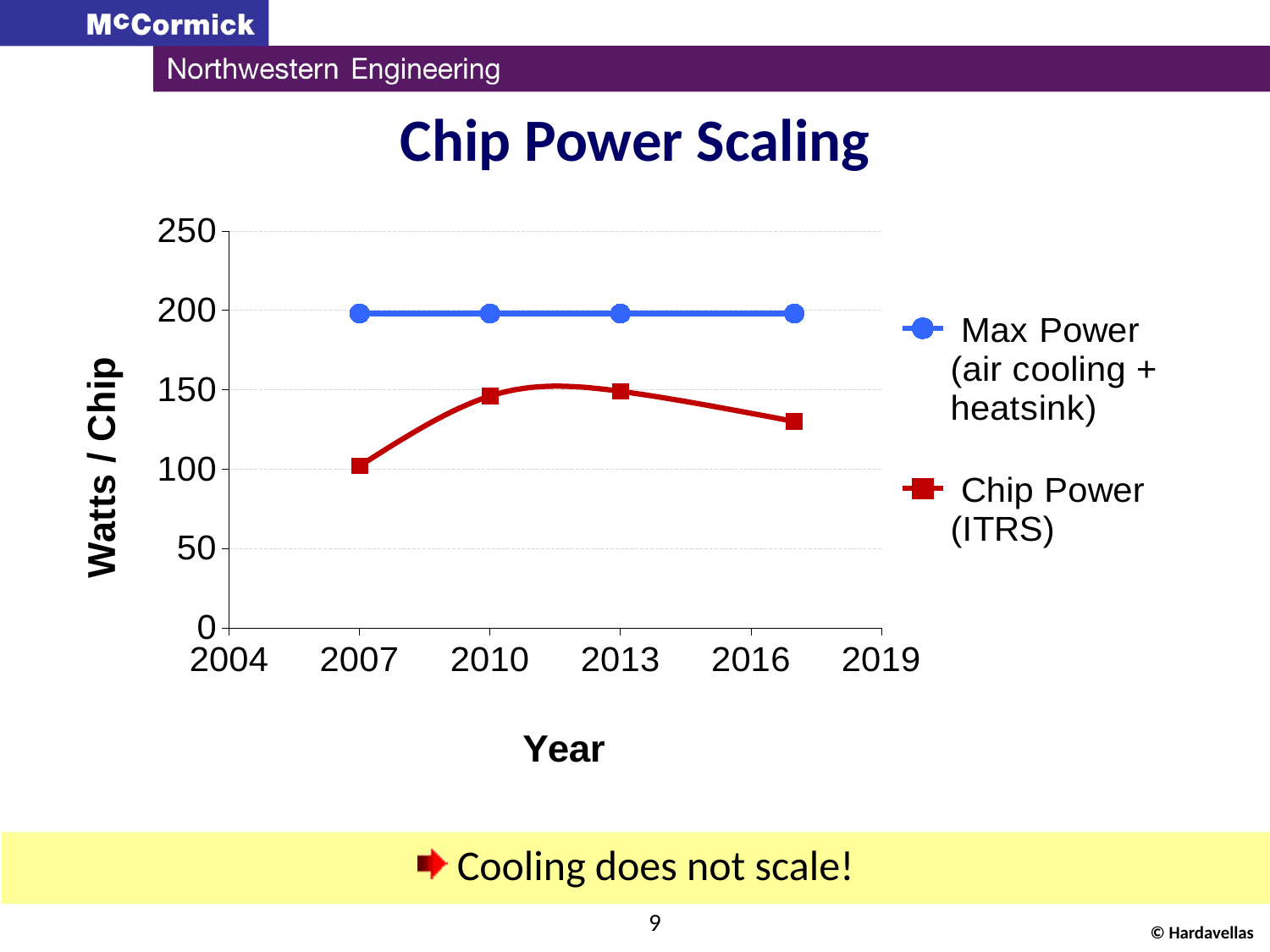
In which year is the Chip Power (ITRS) value lowest? 2007 In 2007, which series has the larger value: Max Power (air cooling + heatsink) or Chip Power (ITRS)? Max Power (air cooling + heatsink) What is the title of the chart? Chip Power Scaling Is the last plotted value for Chip Power (ITRS) greater or less than 150? less What kind of chart is shown on the slide? line chart Is the value for Chip Power (ITRS) in 2007 greater or less than 150? less How many series does the legend list? 2 Is the value for Max Power (air cooling + heatsink) in 2007 greater or less than 150? greater Does the Max Power (air cooling + heatsink) series rise, fall, or stay flat across the years? stays flat What is the label of the y axis? Watts / Chip How many data points are plotted for the Chip Power (ITRS) series? 4